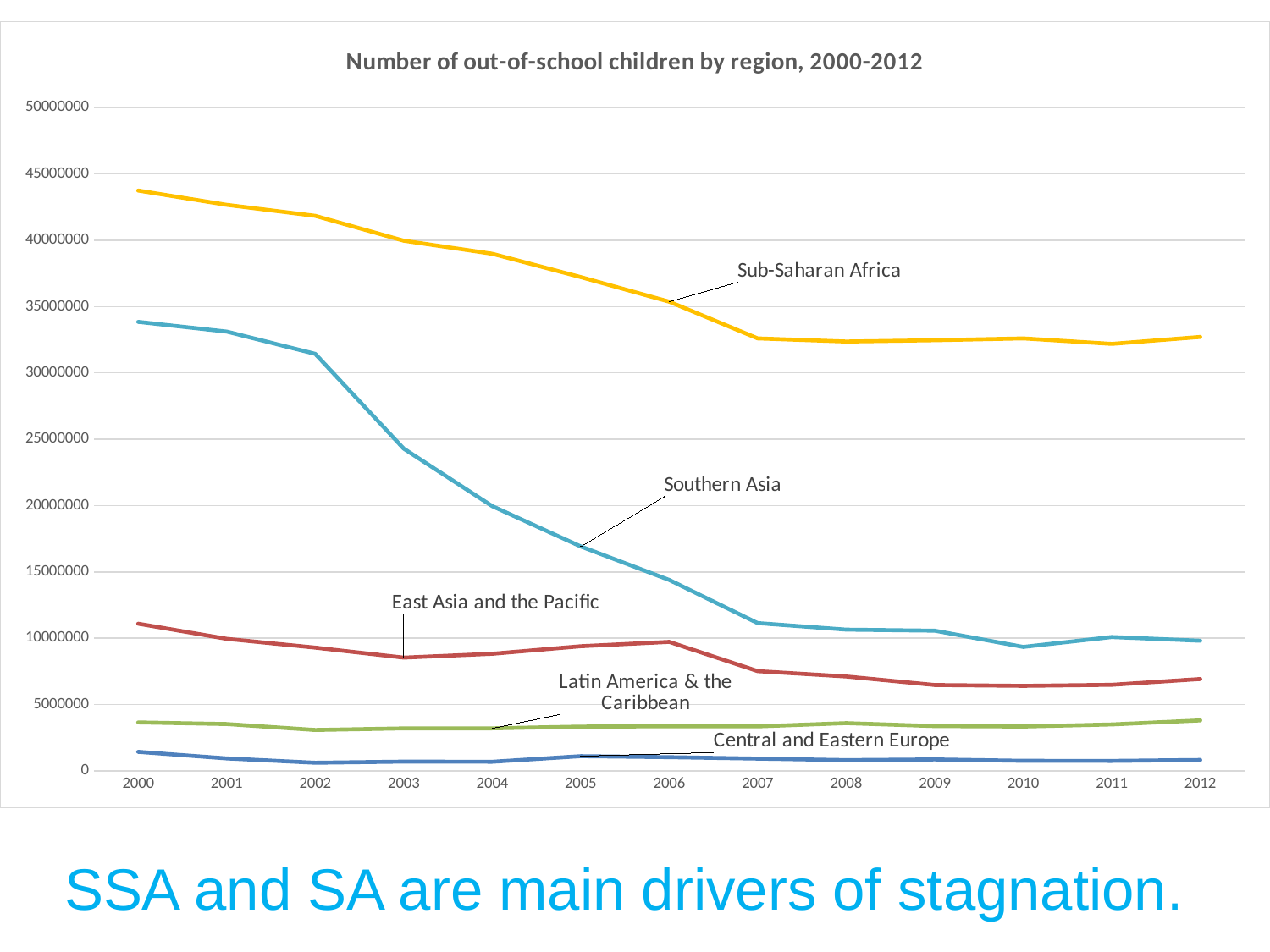
What type of chart is shown on the slide? line chart Is the value for Southern Asia in 2000 greater or less than 30000000? greater Is the value for Sub-Saharan Africa in 2000 greater or less than 40000000? greater What is the title of the chart? Number of out-of-school children by region, 2000-2012 Which region has the lowest number of out-of-school children across the whole period? Central and Eastern Europe Which region has the highest number of out-of-school children in 2012? Sub-Saharan Africa In 2000, which region has more out-of-school children: Sub-Saharan Africa or Southern Asia? Sub-Saharan Africa Does the Southern Asia line rise or fall from 2000 to 2012? fall How many years are shown along the x axis? 13 Is the value for Latin America & the Caribbean in 2000 greater or less than 5000000? less How many regions (lines) are plotted on the chart? 5